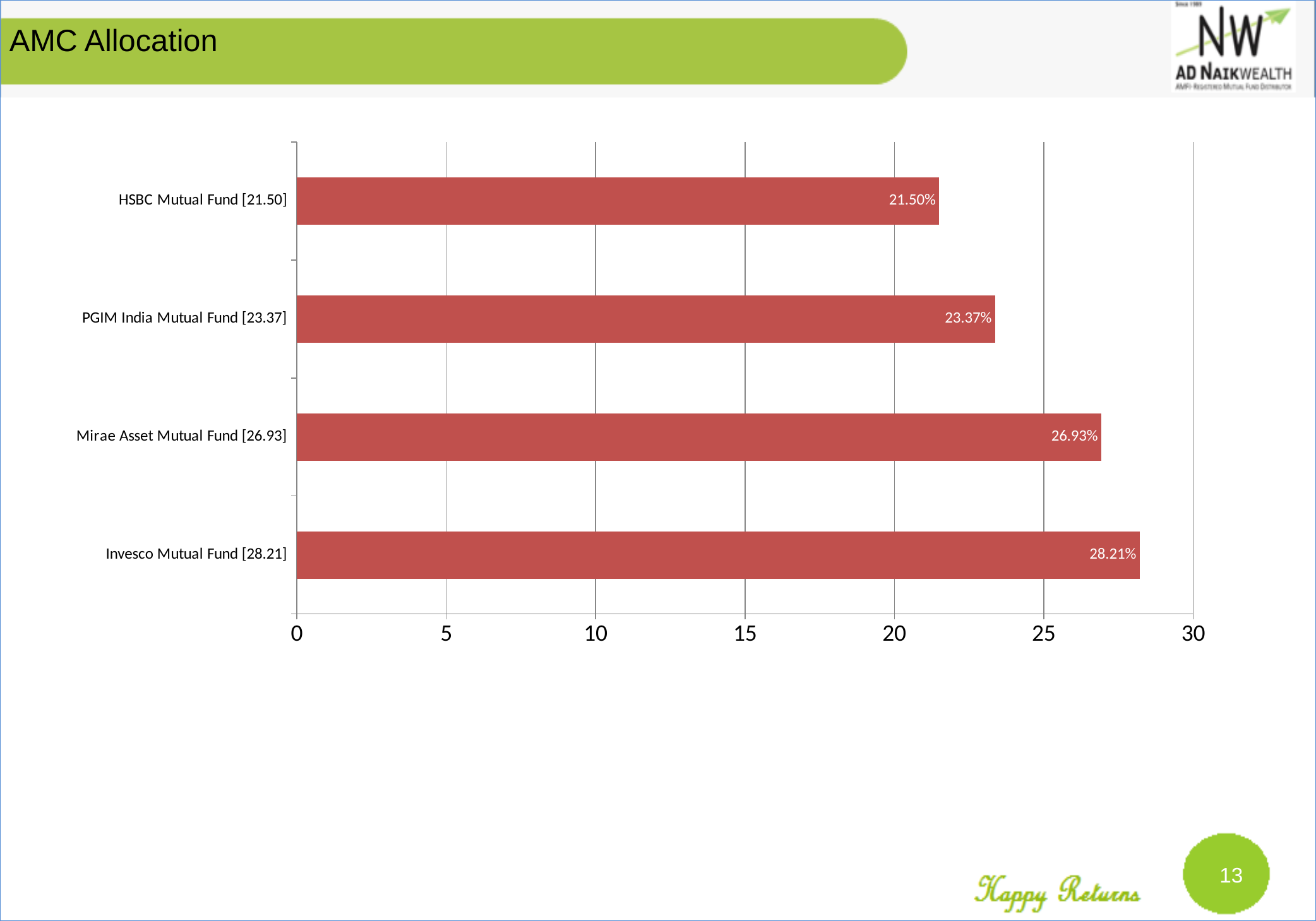
Which fund has the highest allocation? Invesco Mutual Fund What is the difference between the values for Mirae Asset Mutual Fund and PGIM India Mutual Fund? 3.56% What is the value for Invesco Mutual Fund? 28.21% What is the value for HSBC Mutual Fund? 21.50% What is the value for PGIM India Mutual Fund? 23.37% How many funds are shown in the chart? 4 What is the value for Mirae Asset Mutual Fund? 26.93% What kind of chart is shown on the slide? Bar chart What is the difference between the values for Invesco Mutual Fund and HSBC Mutual Fund? 6.71% Is the value for Invesco Mutual Fund greater or less than 25? greater Which fund has the lowest allocation? HSBC Mutual Fund Which is larger, the value for PGIM India Mutual Fund or the value for Mirae Asset Mutual Fund? Mirae Asset Mutual Fund